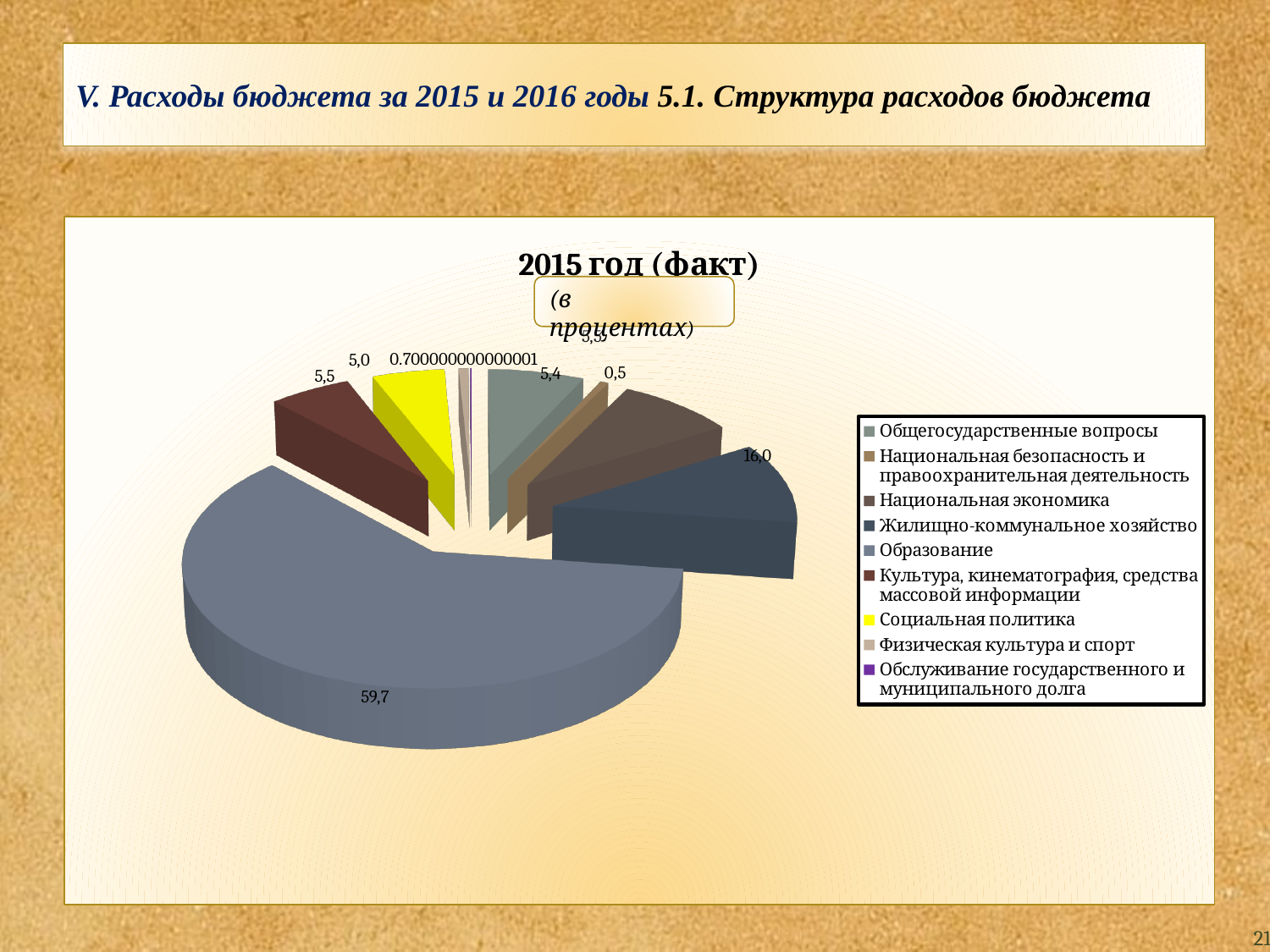
What is the value shown for Жилищно-коммунальное хозяйство? 16,0 What is the title of the chart? 2015 год (факт) What is the value shown for Образование? 59,7 Which is larger, the share for Культура, кинематография, средства массовой информации or the share for Социальная политика? Культура, кинематография, средства массовой информации What colour is the slice for Социальная политика? yellow What is the value shown for Национальная безопасность и правоохранительная деятельность? 0,5 How many categories does the legend list? 9 What is the value shown for Социальная политика? 5,0 Which category has the largest share of the pie? Образование What is the value shown for Общегосударственные вопросы? 5,4 What is the difference between the values for Образование and Жилищно-коммунальное хозяйство? 43,7 What kind of chart is shown on the slide? pie chart